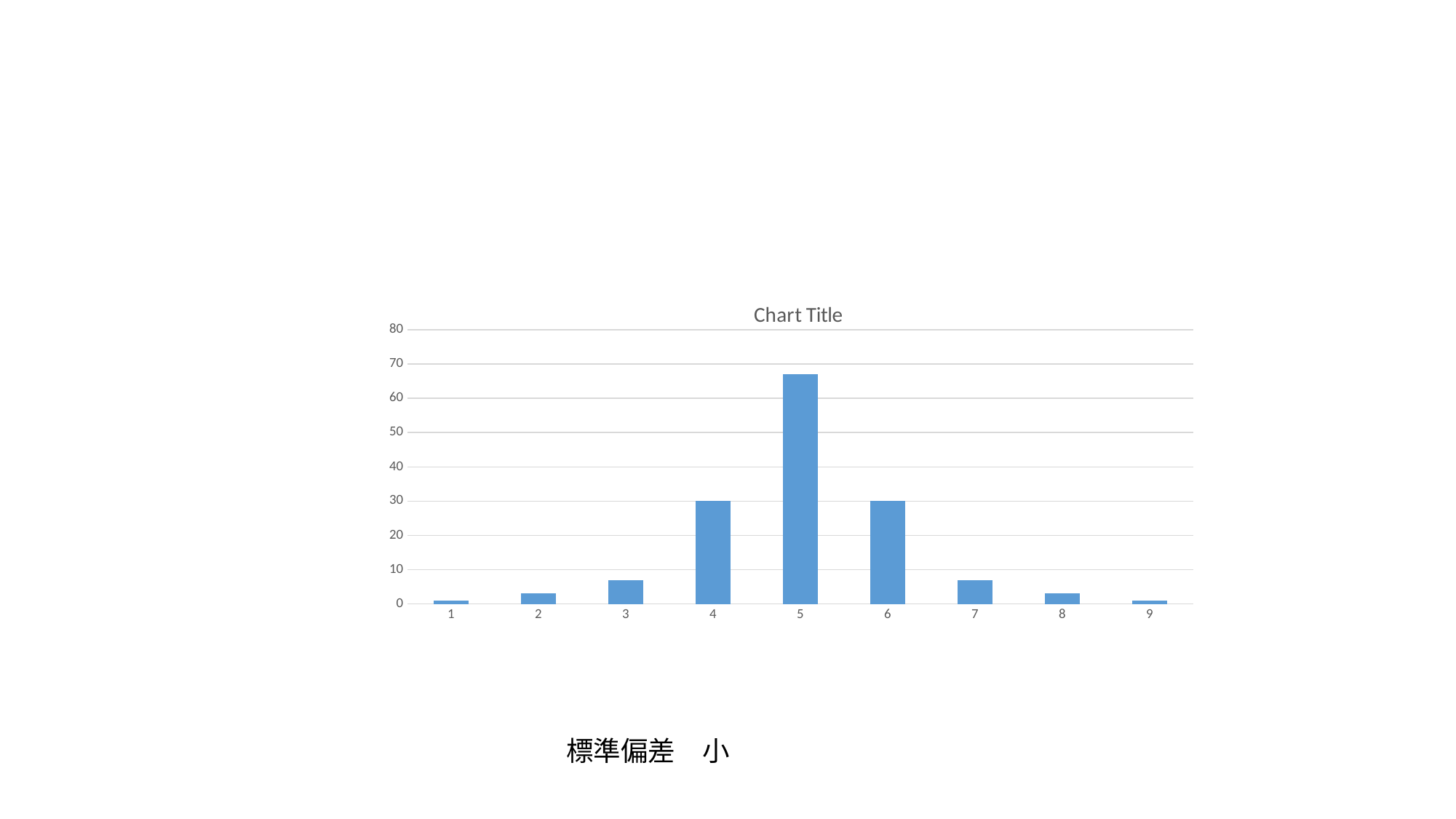
Which is larger, the value for category 4 or the value for category 3? category 4 How many categories are shown on the x axis of the chart? 9 Which category has the highest bar? 5 Do the values rise or fall from category 5 to category 9? fall What is the value for category 4? 30 Is the value for category 8 greater or less than 10? less What is the title of the chart? Chart Title What is the value for category 6? 30 What kind of chart is shown on the slide? bar chart Is the value for category 3 greater or less than 10? less Which is larger, the value for category 5 or the value for category 4? category 5 Is the value for category 5 greater or less than 60? greater